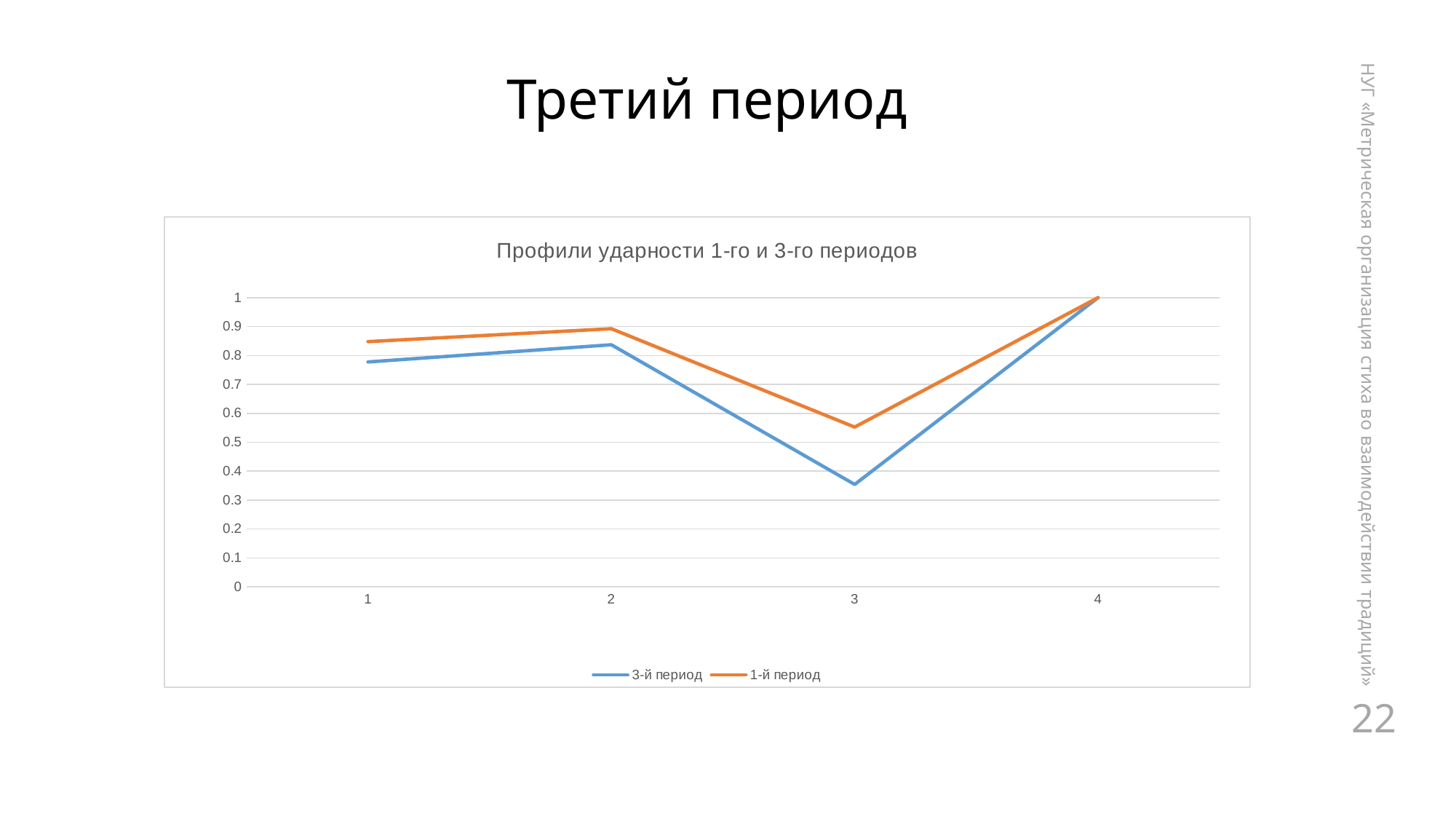
How many points are plotted along the x axis for each series? 4 At x = 3, which series has the larger value, "1-й период" or "3-й период"? 1-й период Is the value of the "3-й период" series at x = 3 greater or less than 0.4? less Does the "3-й период" series rise or fall from x = 3 to x = 4? rise At which x value is the "3-й период" series lowest? 3 What is the value of the "1-й период" series at x = 4? 1 At which x value is the "1-й период" series highest? 4 What is the value of the "3-й период" series at x = 4? 1 What is the title of the chart? Профили ударности 1-го и 3-го периодов How many series does the legend list? 2 What kind of chart is shown on the slide? line chart Is the value of the "1-й период" series at x = 3 greater or less than 0.5? greater